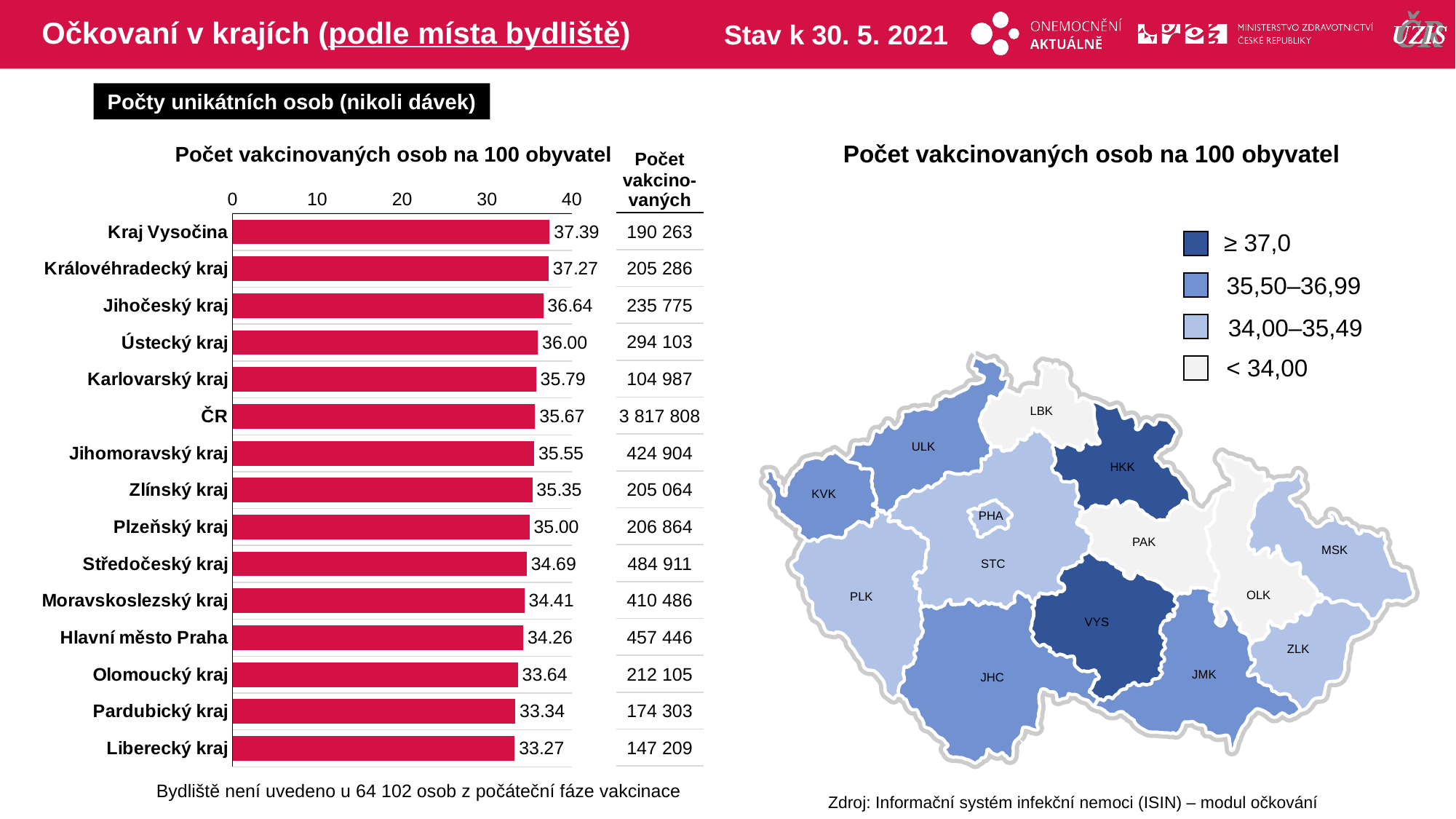
In the bar chart, what is the value for Hlavní město Praha? 34.26 In the bar chart, which is larger: the value for Jihočeský kraj or the value for Zlínský kraj? Jihočeský kraj In the bar chart, what is the value for ČR? 35.67 In the bar chart, which category has the highest value? Kraj Vysočina In the bar chart, which category has the lowest value? Liberecký kraj What kind of chart is shown on the left side of the slide under 'Počet vakcinovaných osob na 100 obyvatel'? bar chart How many categories (bars) are shown in the bar chart? 15 In the bar chart, what is the value for Kraj Vysočina? 37.39 In the bar chart, is the value for Pardubický kraj greater or less than 30? greater In the bar chart, what is the difference between the values for Kraj Vysočina and Liberecký kraj? 4.12 In the 'Počet vakcinovaných' column next to the bar chart, what is the number for Středočeský kraj? 484 911 How many legend categories does the map on the right side of the slide show? 4